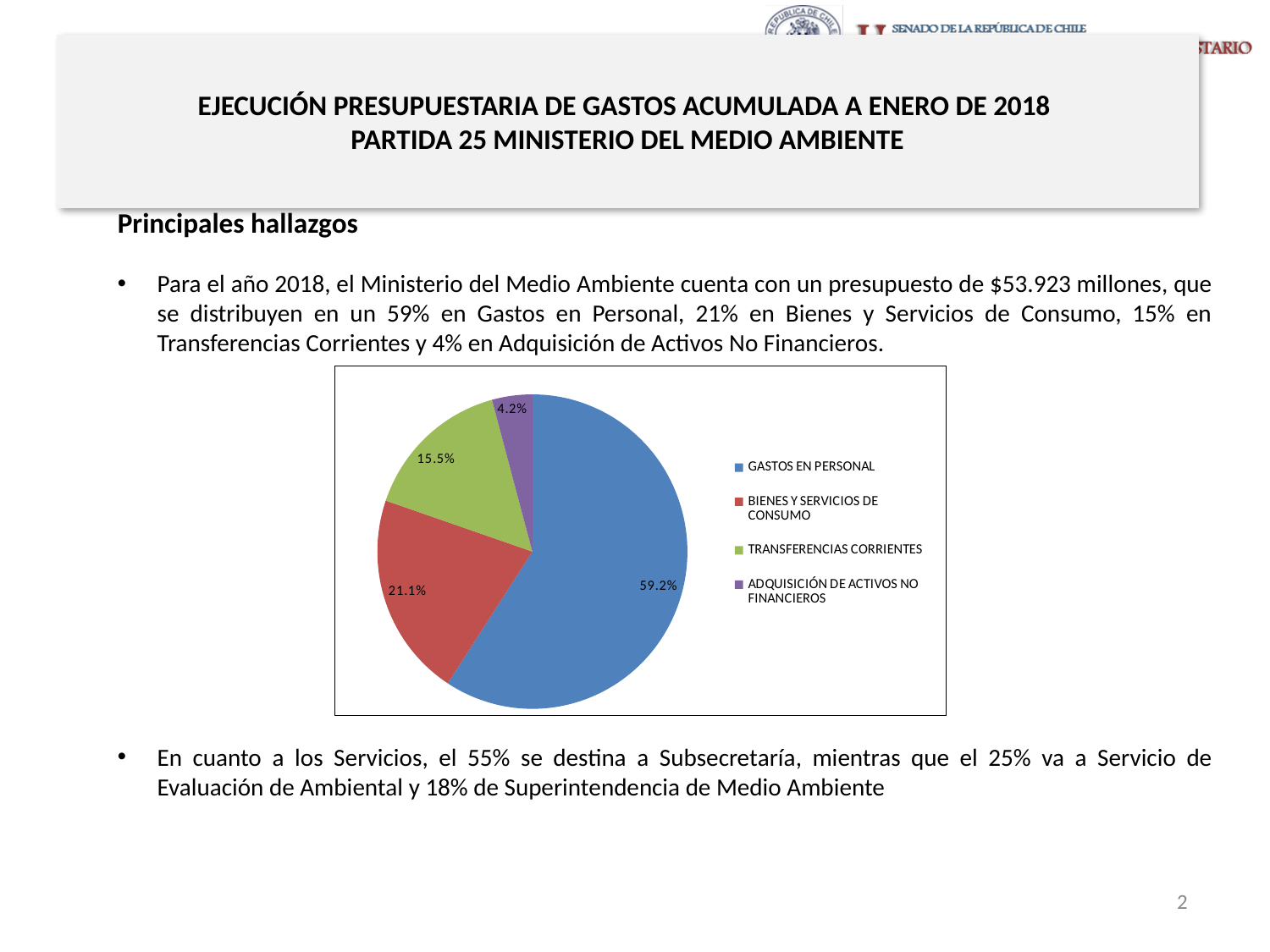
What is the difference in percentage points between GASTOS EN PERSONAL and BIENES Y SERVICIOS DE CONSUMO? 38.1 What share of the pie does GASTOS EN PERSONAL represent? 59.2% What share of the pie does TRANSFERENCIAS CORRIENTES represent? 15.5% What share of the pie does ADQUISICIÓN DE ACTIVOS NO FINANCIEROS represent? 4.2% What colour is the slice for GASTOS EN PERSONAL? Blue Which category has the largest slice of the pie? GASTOS EN PERSONAL Which is larger, the slice for TRANSFERENCIAS CORRIENTES or the slice for BIENES Y SERVICIOS DE CONSUMO? BIENES Y SERVICIOS DE CONSUMO How many entries does the chart legend list? 4 What share of the pie does BIENES Y SERVICIOS DE CONSUMO represent? 21.1% Which category has the smallest slice of the pie? ADQUISICIÓN DE ACTIVOS NO FINANCIEROS What kind of chart is shown on the slide? Pie chart How many slices does the pie chart have? 4